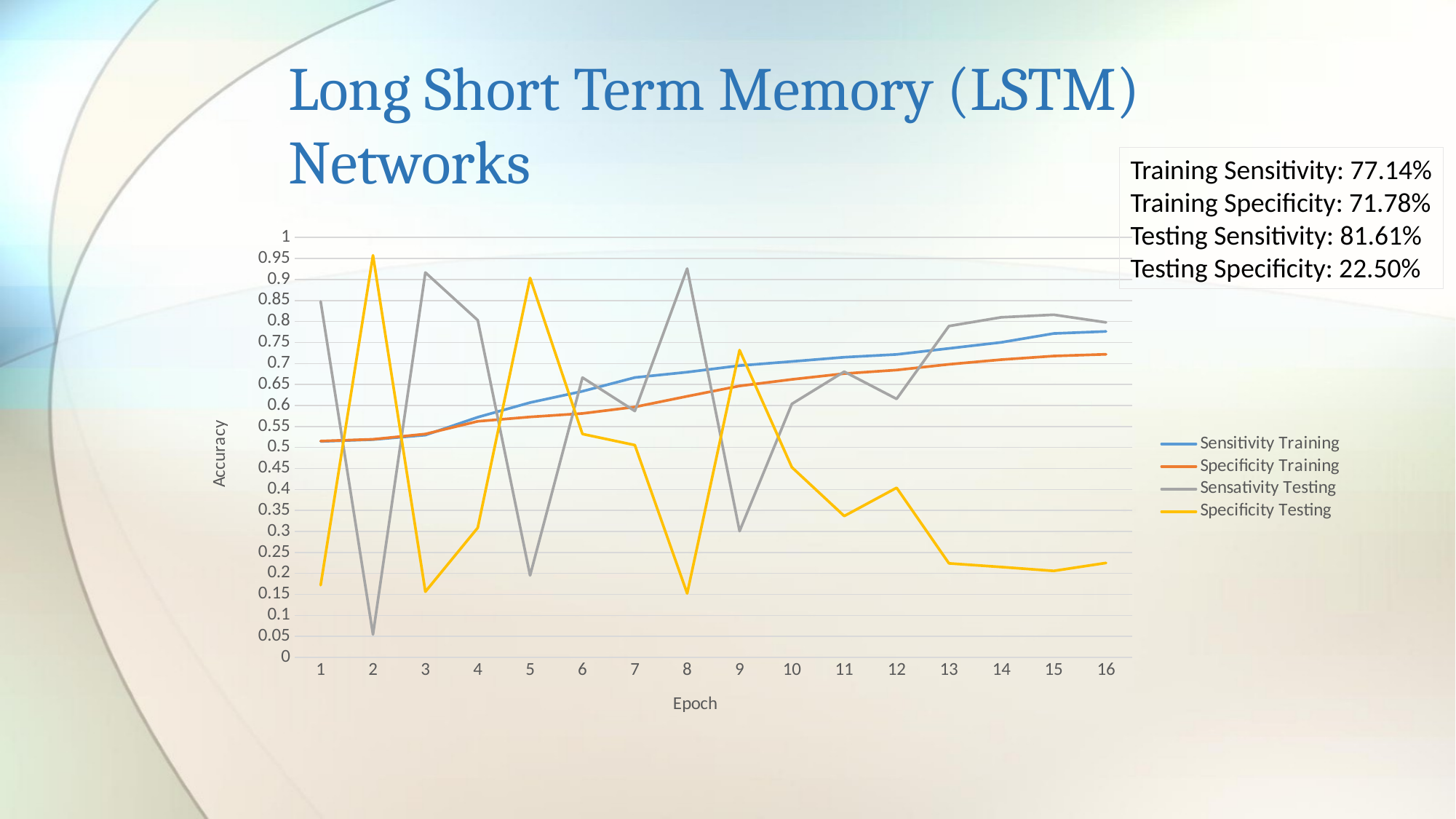
What is the label of the chart's y axis? Accuracy Does the Sensitivity Training series rise or fall from epoch 1 to epoch 16? rise Is the value for Sensativity Testing at epoch 2 greater or less than 0.1? less At which epoch does the Sensativity Testing series reach its lowest value? 2 Does the Specificity Training series rise or fall across the epochs? rise Is the value for Specificity Testing at epoch 16 greater or less than 0.3? less At which epoch does the Specificity Testing series reach its highest value? 2 At epoch 16, which is larger: Sensitivity Training or Specificity Training? Sensitivity Training What kind of chart is shown on the slide? line chart How many epochs are plotted along the x axis? 16 How many series does the chart legend list? 4 Is the value for Sensitivity Training at epoch 16 greater or less than 0.7? greater